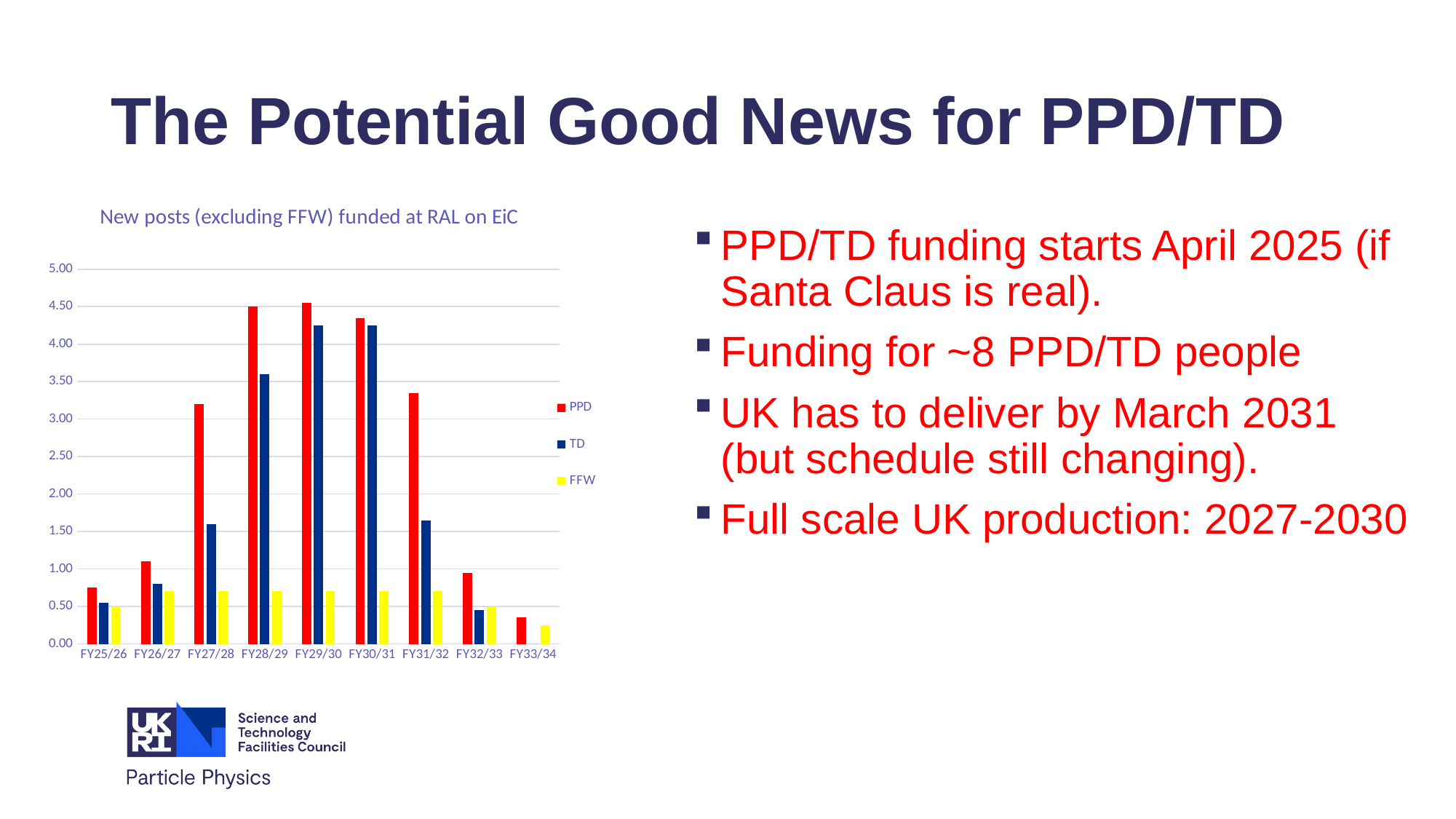
How many fiscal years are shown on the x axis of the chart? 9 Is the TD value for FY28/29 greater or less than 3.00? greater In FY31/32, which is larger, the PPD value or the TD value? PPD Which colour represents the TD series in the chart? blue How many series does the chart legend list? 3 What kind of chart is shown on the slide? bar chart What is the title of the chart? New posts (excluding FFW) funded at RAL on EiC Do the PPD values rise or fall from FY25/26 to FY28/29? rise Is the TD value for FY27/28 greater or less than 2.00? less In which fiscal year is the PPD value lowest? FY33/34 Is the PPD value for FY27/28 greater or less than 3.00? greater